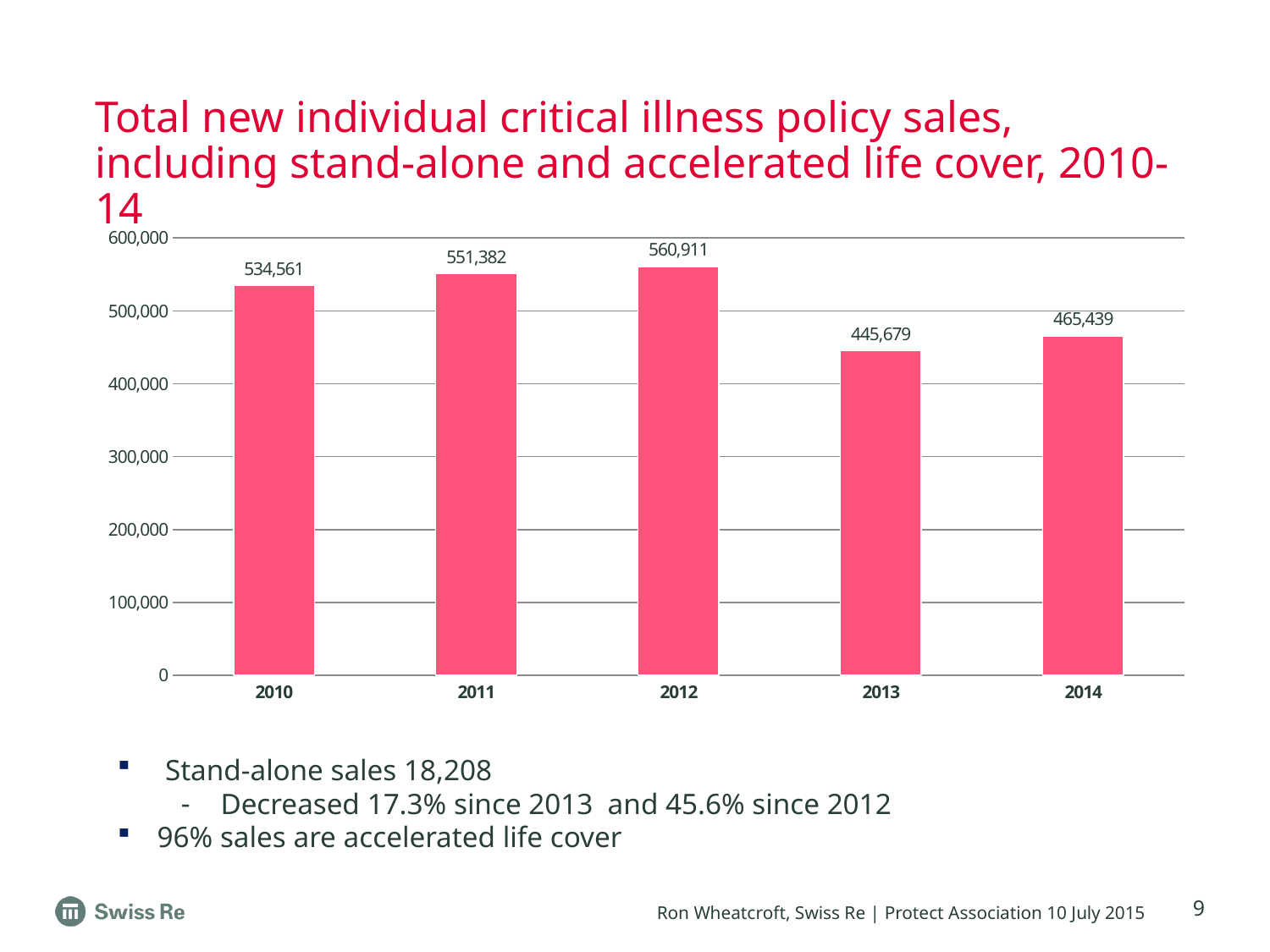
What is the value for 2013? 445,679 Which is larger, the value for 2011 or the value for 2014? 2011 What is the difference between the values for 2011 and 2010? 16,821 What is the value for 2010? 534,561 What kind of chart is shown on the slide? bar chart What is the difference between the values for 2012 and 2013? 115,232 What is the value for 2014? 465,439 Is the value for 2013 greater or less than 500,000? less How many years are shown on the x axis? 5 Which year has the lowest value? 2013 Do the values rise or fall from 2012 to 2013? fall Which year has the highest value? 2012